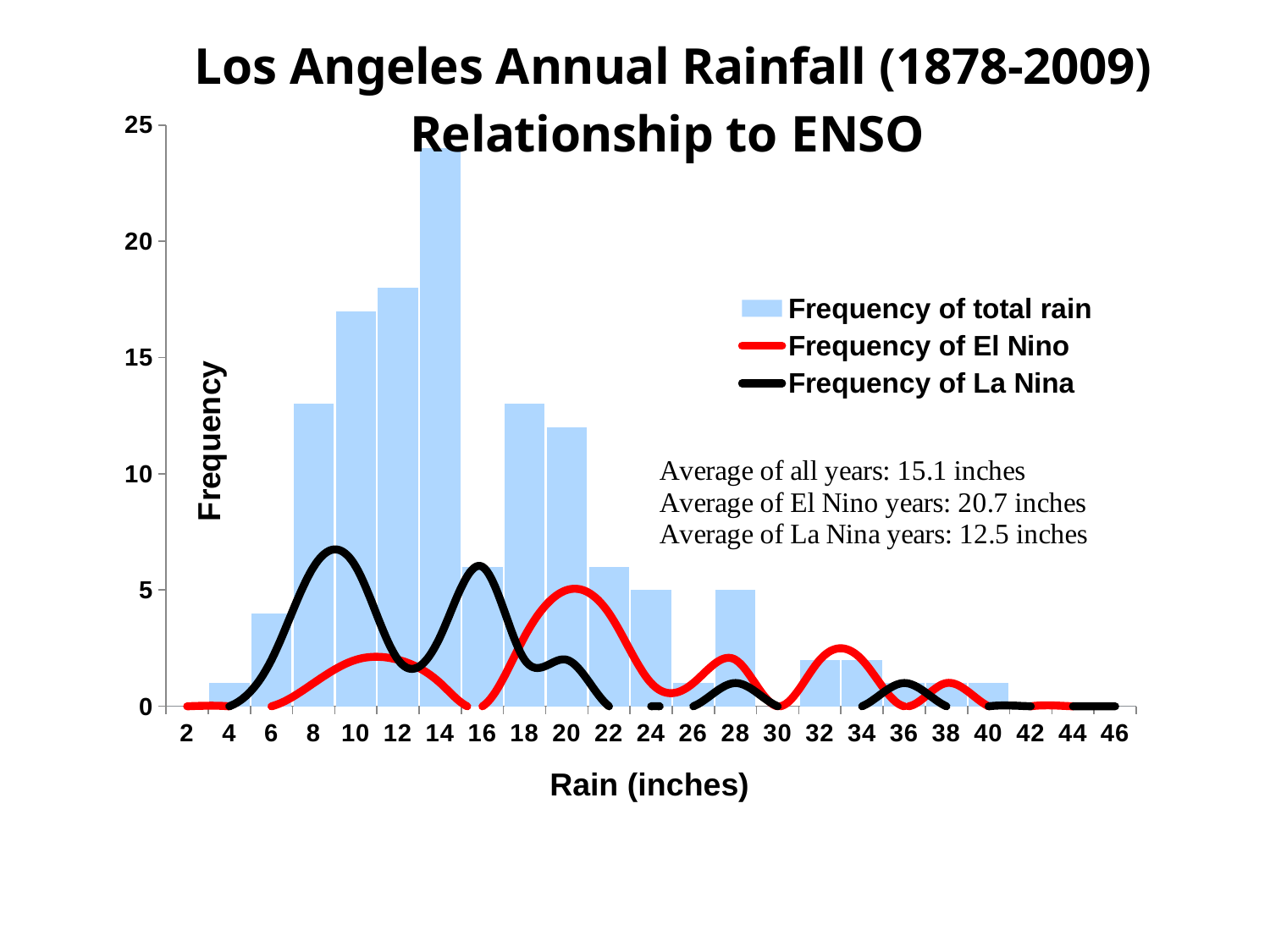
Which has a higher Frequency of total rain, 8 inches or 16 inches? 8 inches What colour is the Frequency of El Nino line in the legend? red Is the Frequency of total rain at 20 inches greater or less than 10? greater What is the title of the x axis? Rain (inches) Is the Frequency of total rain at 12 inches greater or less than 15? greater What kind of chart is used to show the Frequency of total rain series? bar chart Is the Frequency of total rain at 14 inches greater or less than 20? greater Which has a higher Frequency of total rain, 10 inches or 18 inches? 10 inches How many series does the legend list? 3 At which rainfall amount (inches) is the Frequency of total rain highest? 14 Between 4 and 14 inches, do the Frequency of total rain bars rise or fall as rainfall increases? rise